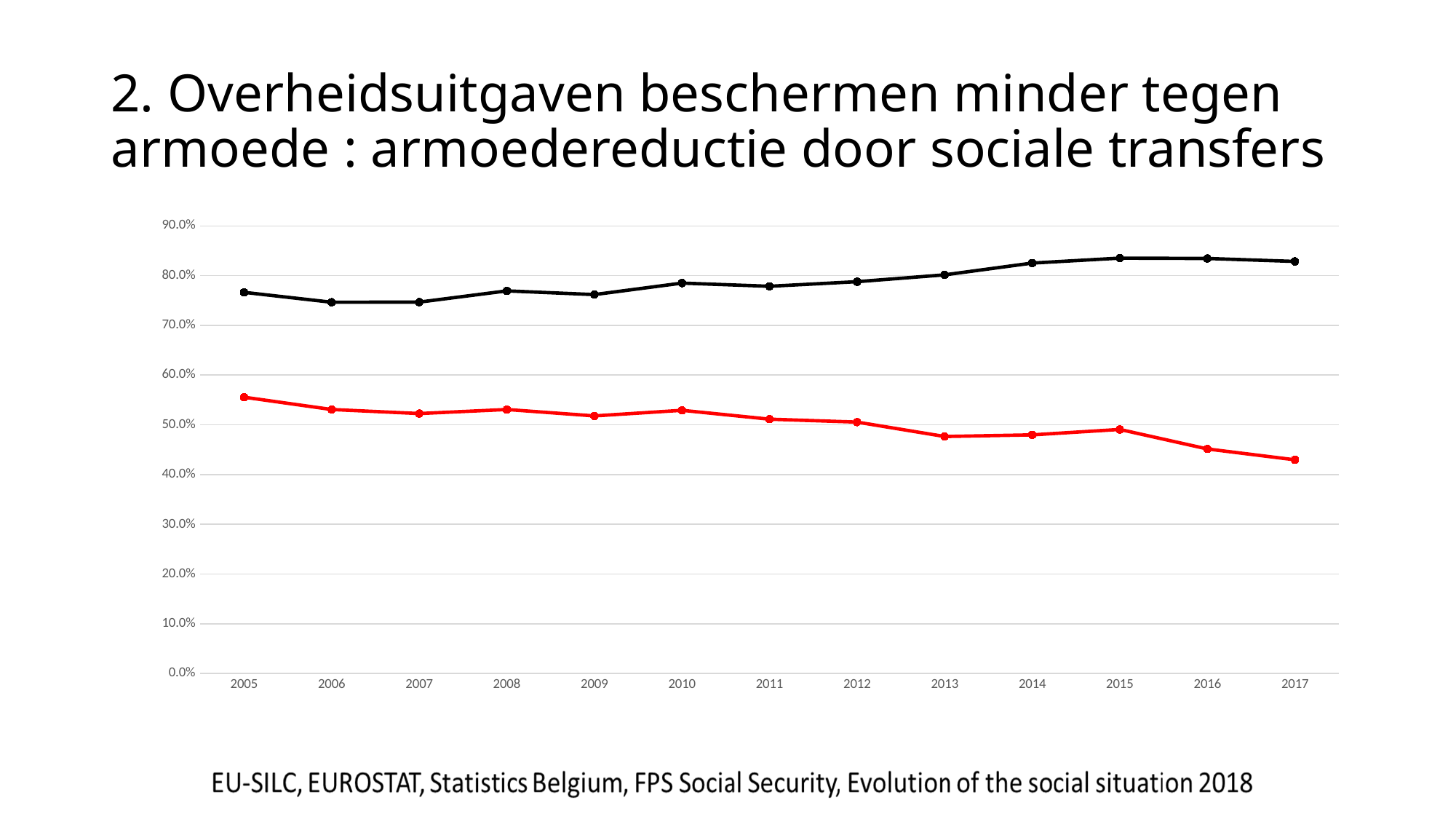
Does the black line rise or fall overall from 2005 to 2017? rise In 2010, which line has the higher value, the black line or the red line? the black line What is the last year shown on the x axis? 2017 How many years are plotted along the x axis of the chart? 13 Is the value of the black line in 2017 greater or less than 80.0%? greater In which year is the red line at its lowest value? 2017 Does the red line rise or fall overall from 2005 to 2017? fall What is the first year shown on the x axis? 2005 How many lines are plotted on the chart? 2 Is the value of the red line in 2017 greater or less than 50.0%? less What kind of chart is shown on the slide? line chart In which year is the red line at its highest value? 2005